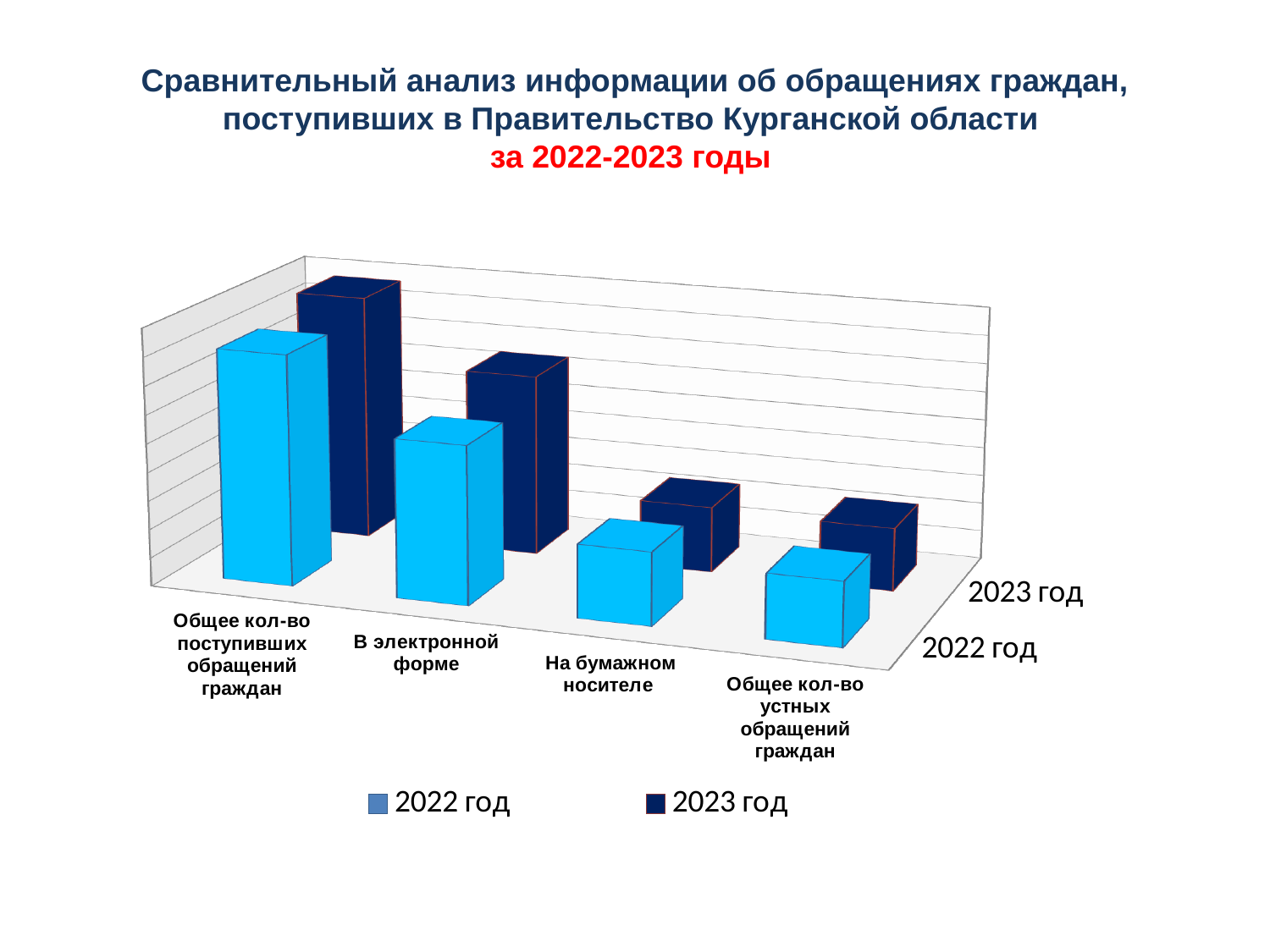
Which series is shown in dark blue in the legend? 2023 год Do the values of the 2022 год series rise or fall moving from left to right along the x axis? fall Which category has the highest value for the 2023 год series? Общее кол-во поступивших обращений граждан Which years does the chart title say the comparative analysis covers? 2022-2023 годы What kind of chart is shown on the slide? bar chart How many categories are shown along the x axis of the chart? 4 For the category 'В электронной форме', which series has the larger value, 2022 год or 2023 год? 2023 год Which category has the lowest value for the 2022 год series? Общее кол-во устных обращений граждан Which category has the highest value for the 2022 год series? Общее кол-во поступивших обращений граждан For the category 'Общее кол-во поступивших обращений граждан', which series has the larger value, 2022 год or 2023 год? 2023 год How many series does the chart legend list? 2